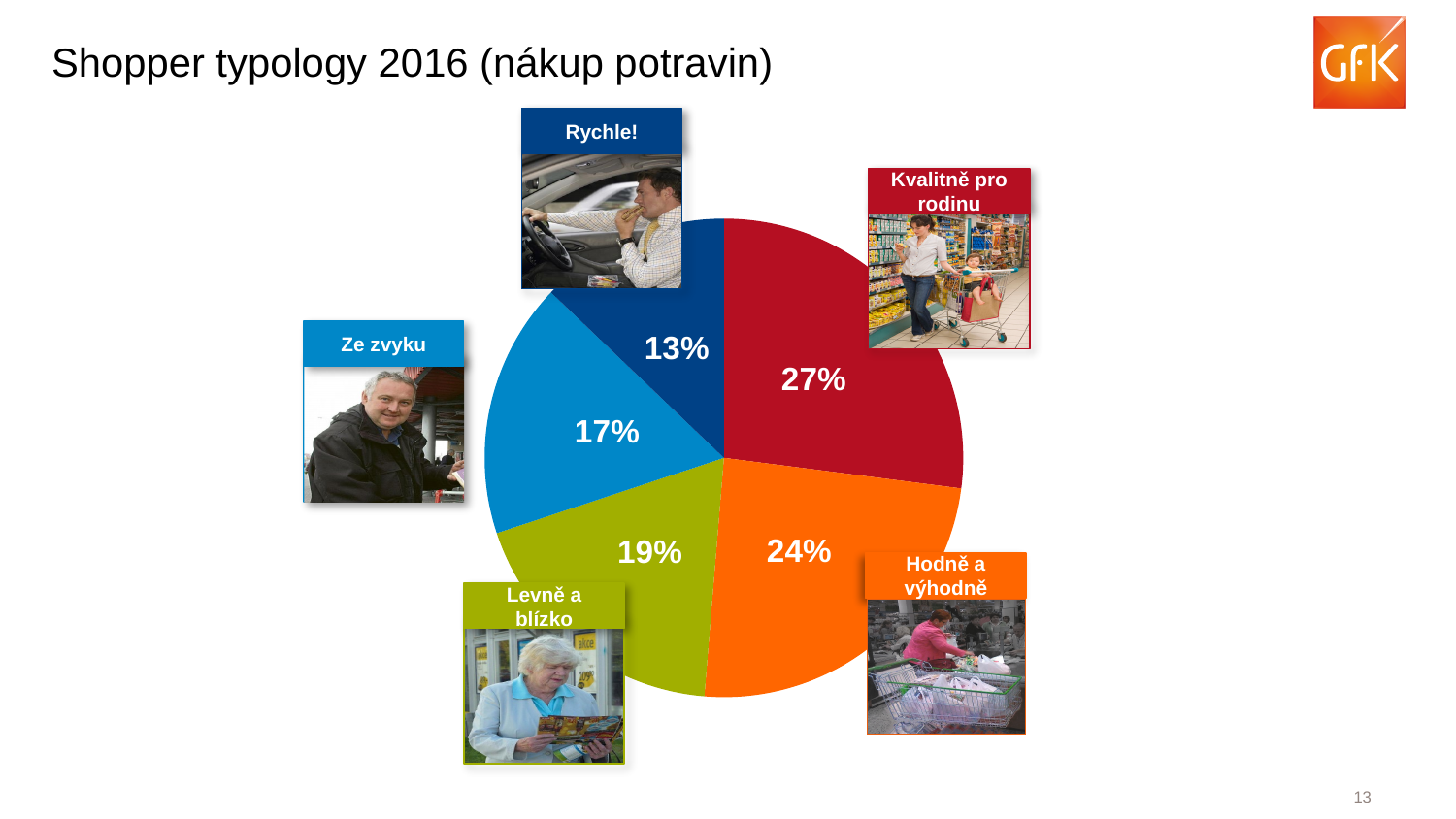
What share of the pie does the "Levně a blízko" segment have? 19% What share of the pie does the "Rychle!" segment have? 13% What is the difference in percentage points between the "Kvalitně pro rodinu" and "Rychle!" segments? 14 percentage points What share of the pie does the "Ze zvyku" segment have? 17% Which shopper type has the smallest share of the pie? Rychle! What colour is the "Hodně a výhodně" segment of the pie? orange Which segment is larger, "Levně a blízko" or "Ze zvyku"? Levně a blízko What share of the pie does the "Kvalitně pro rodinu" segment have? 27% What share of the pie does the "Hodně a výhodně" segment have? 24% Which shopper type has the largest share of the pie? Kvalitně pro rodinu How many segments does the pie chart have? 5 What type of chart is shown on the slide? pie chart